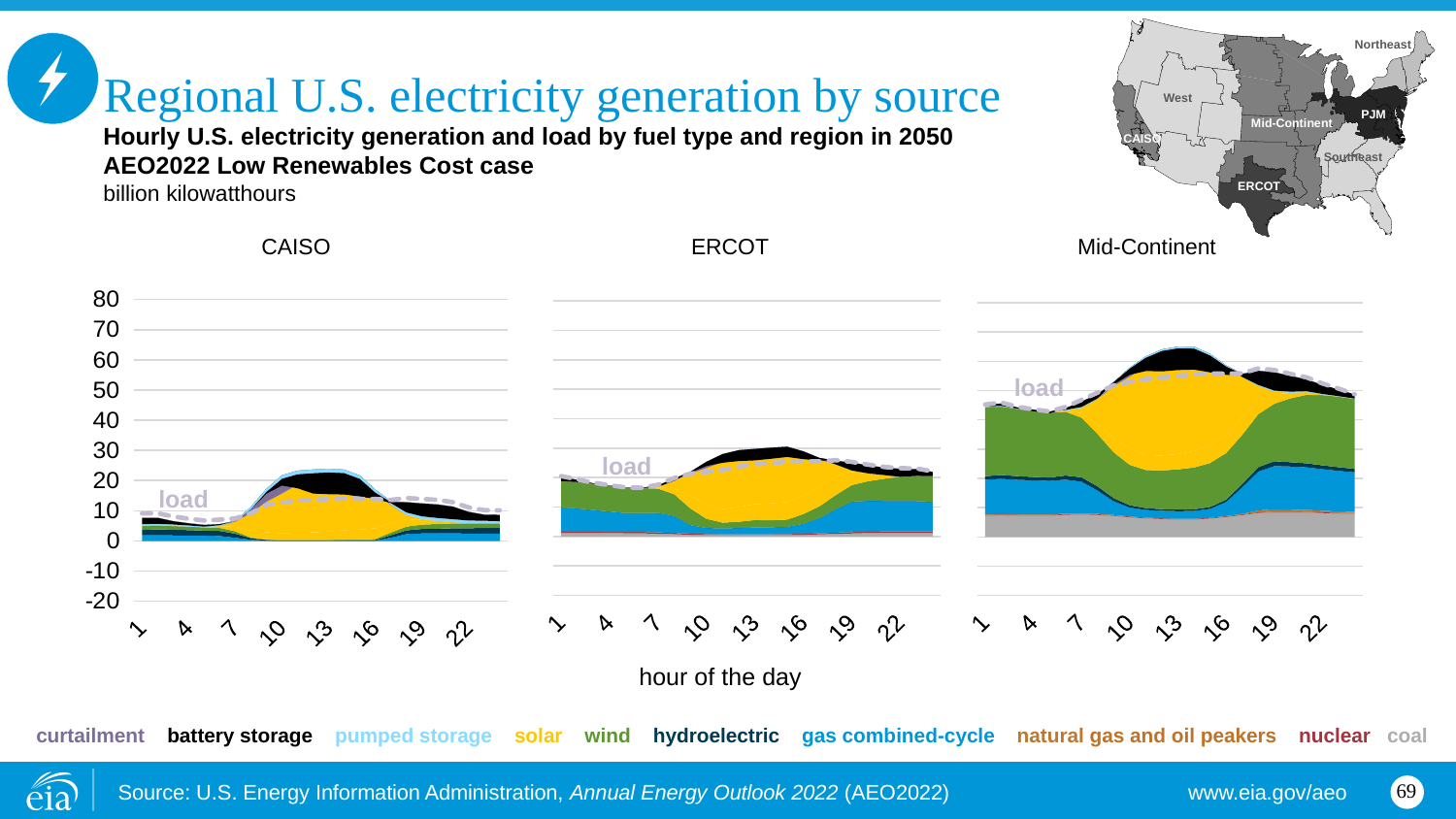
In the Mid-Continent chart, does total generation rise or fall from hour 7 to hour 13? rise In the CAISO chart, is the total generation at hour 1 greater or less than 10? less In the ERCOT chart, is the peak total generation around hour 13 to 16 greater or less than 20? greater How many fuel types does the legend at the bottom of the slide list? 10 In the Mid-Continent chart, is the peak total generation around hour 13 greater or less than 50? greater Which of the three regions has the lowest peak hourly generation? CAISO How many regional charts are shown on the slide? 3 What kind of chart is used for the CAISO, ERCOT and Mid-Continent panels? area chart Which of the three regions has the highest peak hourly generation? Mid-Continent